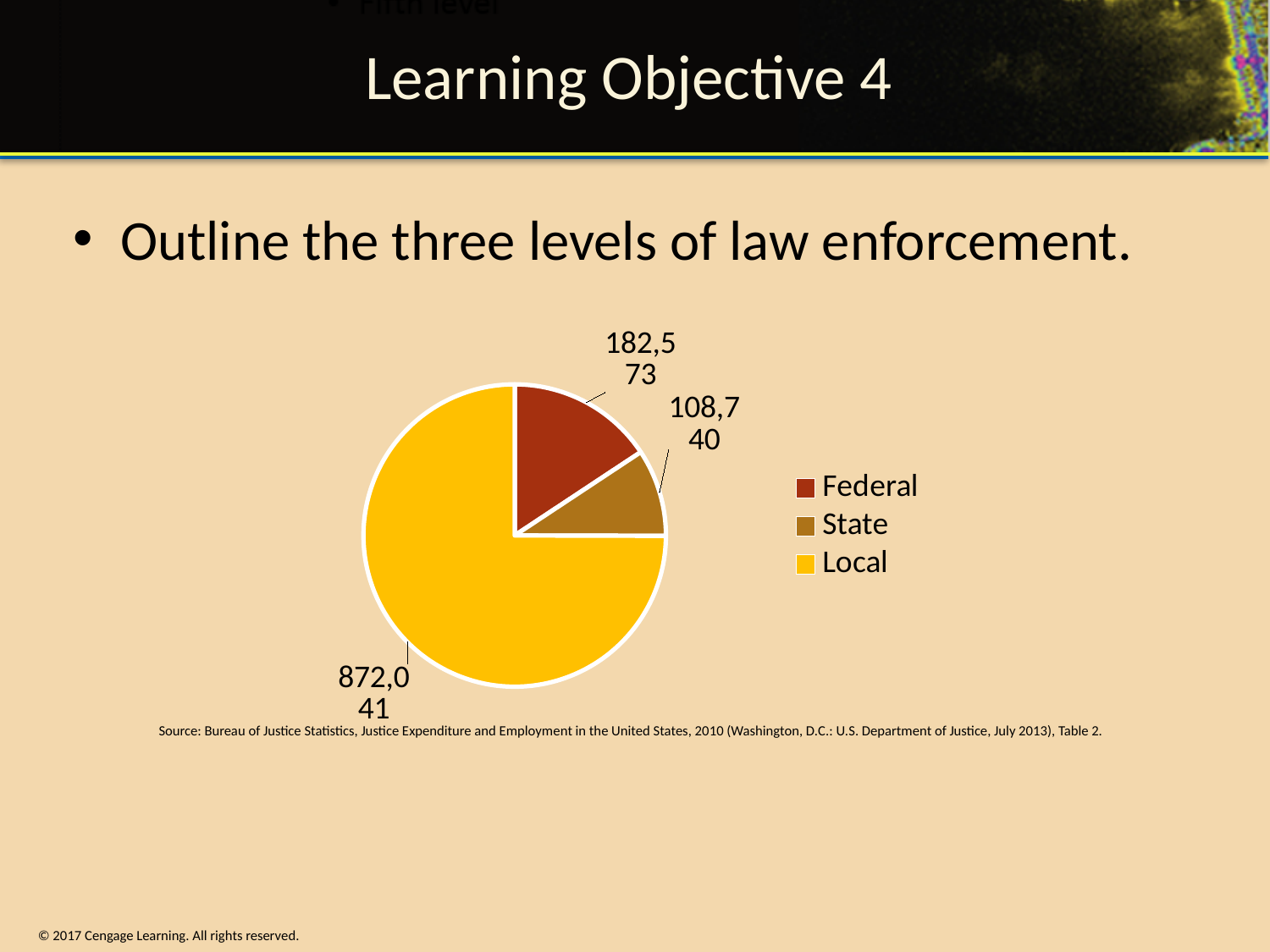
What is the value shown for State in the pie chart? 108,740 How many slices does the pie chart have? 3 What kind of chart is shown on the slide? pie chart Which level of law enforcement has the smallest slice in the pie chart? State What is the difference between the Federal and State values in the pie chart? 73,833 What is the value shown for Federal in the pie chart? 182,573 What is the value shown for Local in the pie chart? 872,041 How many entries does the legend of the pie chart list? 3 What is the difference between the Local and Federal values in the pie chart? 689,468 Which colour represents Local in the pie chart? yellow Which is larger in the pie chart, Federal or State? Federal Which level of law enforcement has the largest slice in the pie chart? Local